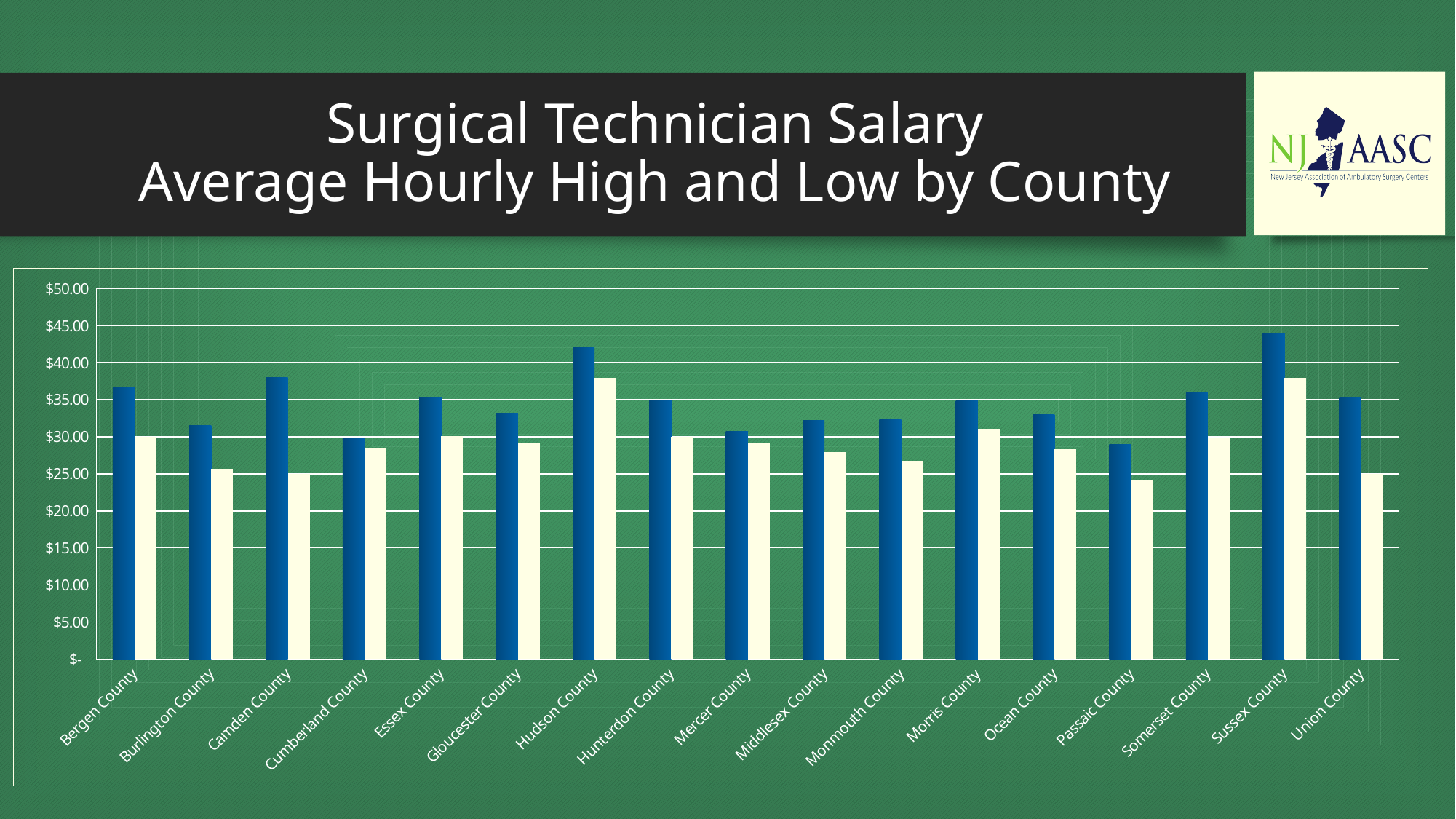
How many counties are shown on the x axis of the chart? 17 Which is taller, the blue bar for Camden County or the blue bar for Burlington County? Camden County Is the cream bar for Camden County greater or less than $30.00? less Which county has the tallest blue bar in the chart? Sussex County Which is taller, the cream bar for Sussex County or the cream bar for Union County? Sussex County Is the blue bar for Hudson County greater or less than $40.00? greater Is the cream bar for Hudson County greater or less than $35.00? greater What is the title of the slide containing the chart? Surgical Technician Salary Average Hourly High and Low by County What kind of chart is shown on the slide? bar chart What is the highest value labelled on the y axis of the chart? $50.00